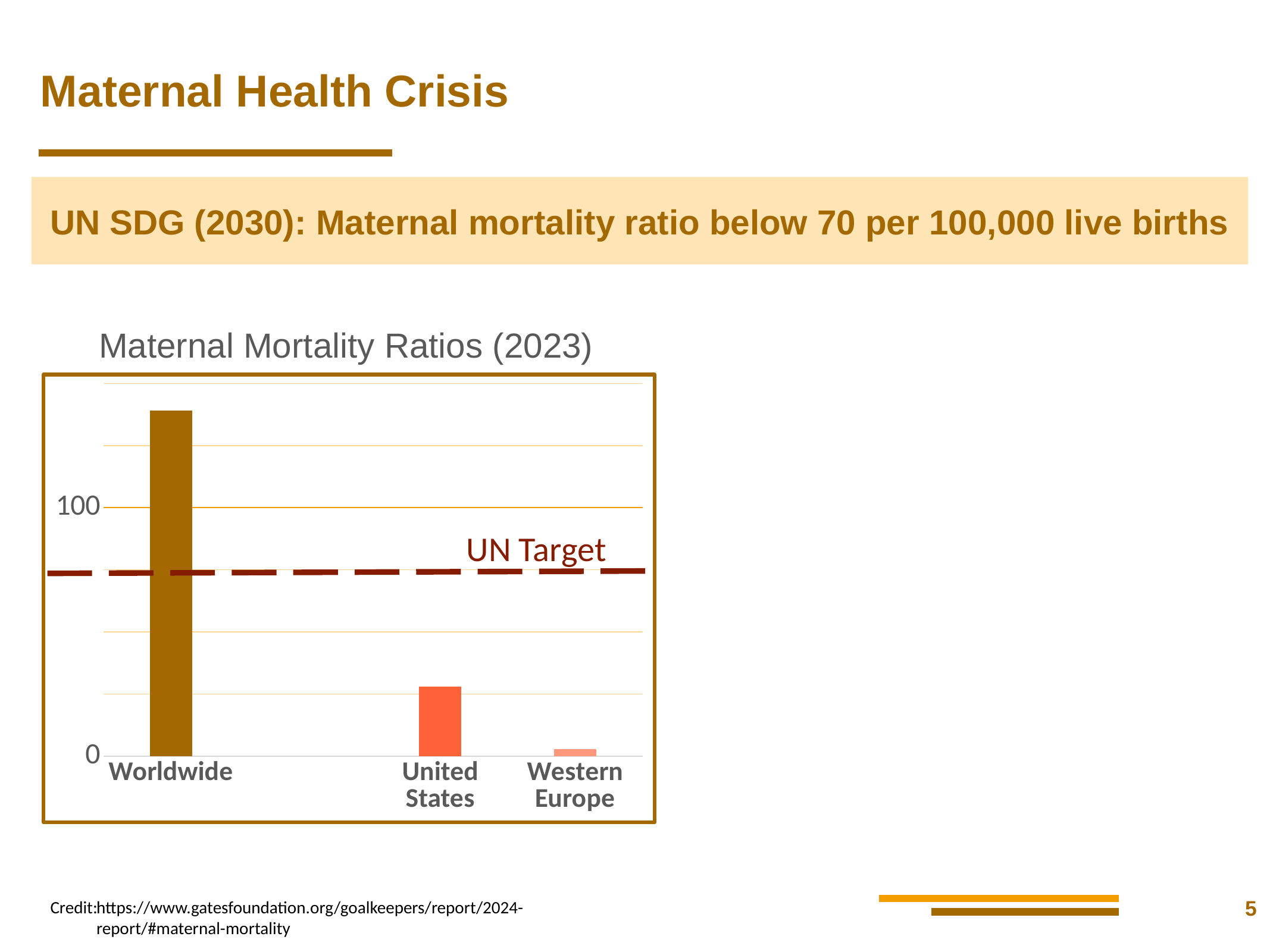
What label is given to the dashed horizontal line in the chart? UN Target Which category has the highest maternal mortality ratio in the chart? Worldwide Is the value for Worldwide greater or less than 100? greater Which category has the lowest maternal mortality ratio in the chart? Western Europe Which has a larger value in the chart, Worldwide or United States? Worldwide Is the value for United States greater or less than 100? less How many categories are plotted in the Maternal Mortality Ratios (2023) chart? 3 Do the bar values rise or fall from left to right across the categories? fall Which has a larger value in the chart, United States or Western Europe? United States Is the value for Western Europe greater or less than 100? less What is the title of the chart? Maternal Mortality Ratios (2023) What kind of chart is shown on the slide? bar chart